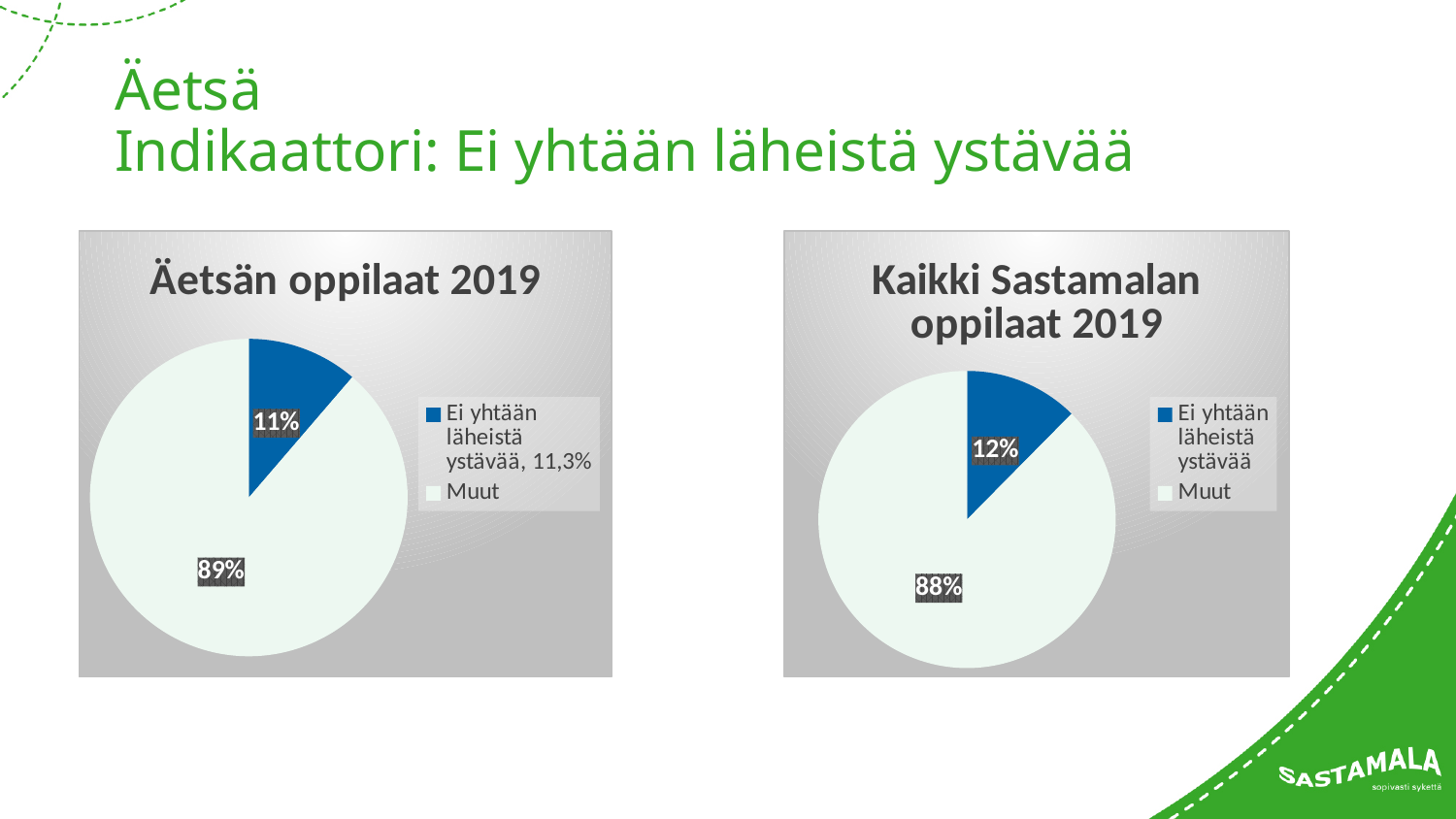
In the chart titled "Äetsän oppilaat 2019", what share of the pie is labelled "Ei yhtään läheistä ystävää"? 11% In the chart titled "Äetsän oppilaat 2019", what share of the pie is labelled "Muut"? 89% In the chart titled "Kaikki Sastamalan oppilaat 2019", what share of the pie is labelled "Muut"? 88% What kind of chart is the chart titled "Äetsän oppilaat 2019"? Pie chart How many slices does the chart titled "Äetsän oppilaat 2019" have? 2 In the chart titled "Äetsän oppilaat 2019", which slice is the largest? Muut What kind of chart is the chart titled "Kaikki Sastamalan oppilaat 2019"? Pie chart In the chart titled "Äetsän oppilaat 2019", what is the difference in percentage points between the "Muut" slice and the "Ei yhtään läheistä ystävää" slice? 78 percentage points In the chart titled "Kaikki Sastamalan oppilaat 2019", which slice is the smallest? Ei yhtään läheistä ystävää In the chart titled "Kaikki Sastamalan oppilaat 2019", what is the difference in percentage points between the "Muut" slice and the "Ei yhtään läheistä ystävää" slice? 76 percentage points In the chart titled "Äetsän oppilaat 2019", what exact percentage is given in the legend for "Ei yhtään läheistä ystävää"? 11,3%